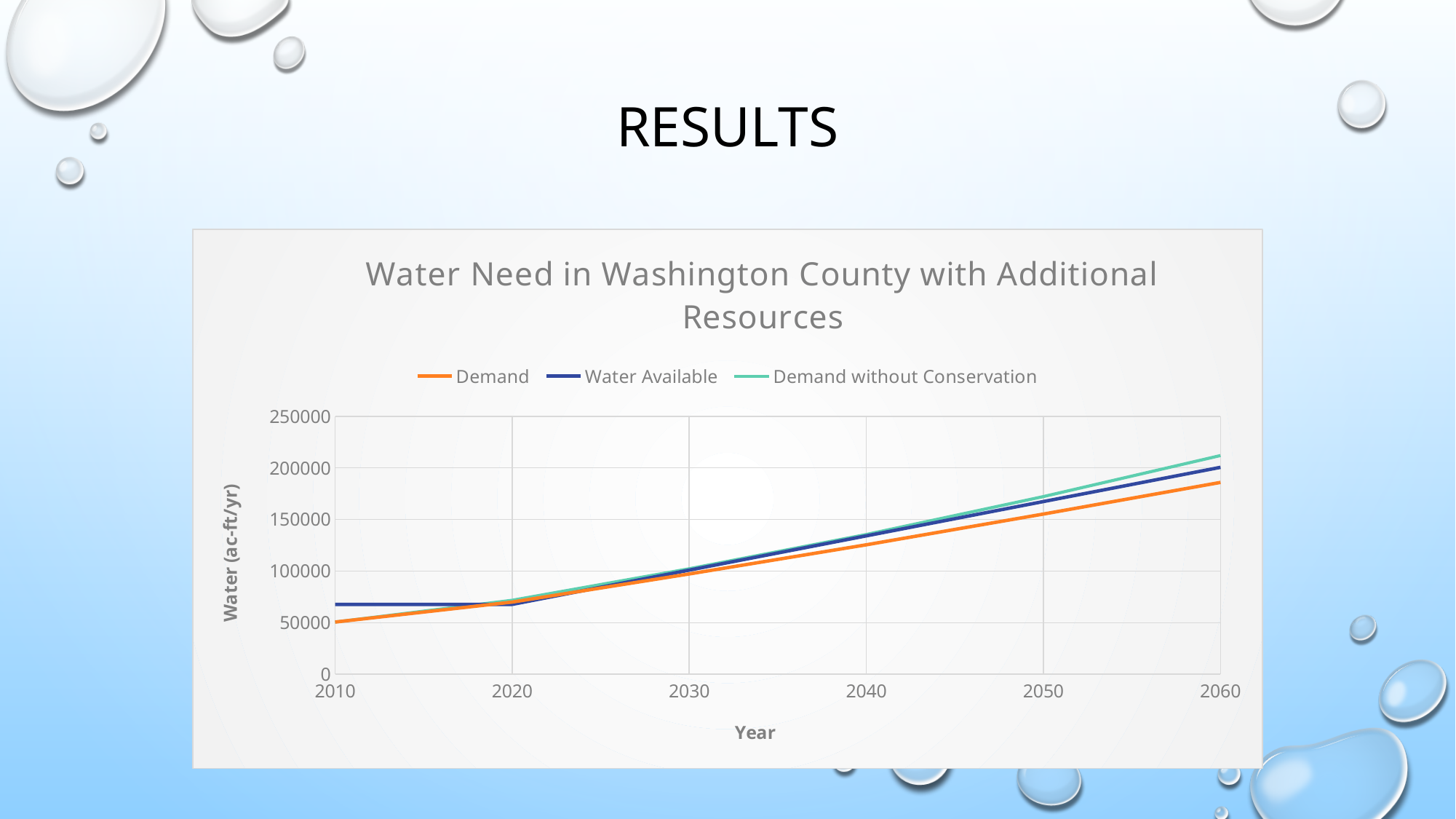
How many year labels are shown on the x axis? 6 Is the value for Demand without Conservation in 2060 greater or less than 200000? greater What is the label of the vertical axis? Water (ac-ft/yr) In 2010, which is larger: Water Available or Demand? Water Available Which series has the lowest value in 2060? Demand Does the Demand series rise or fall from 2010 to 2060? rise Is the value for Demand in 2060 greater or less than 150000? greater How many series does the legend list? 3 Is the value for Demand in 2010 greater or less than 100000? less What kind of chart is shown on the slide? line chart What is the title of the chart? Water Need in Washington County with Additional Resources Which series has the highest value in 2060? Demand without Conservation